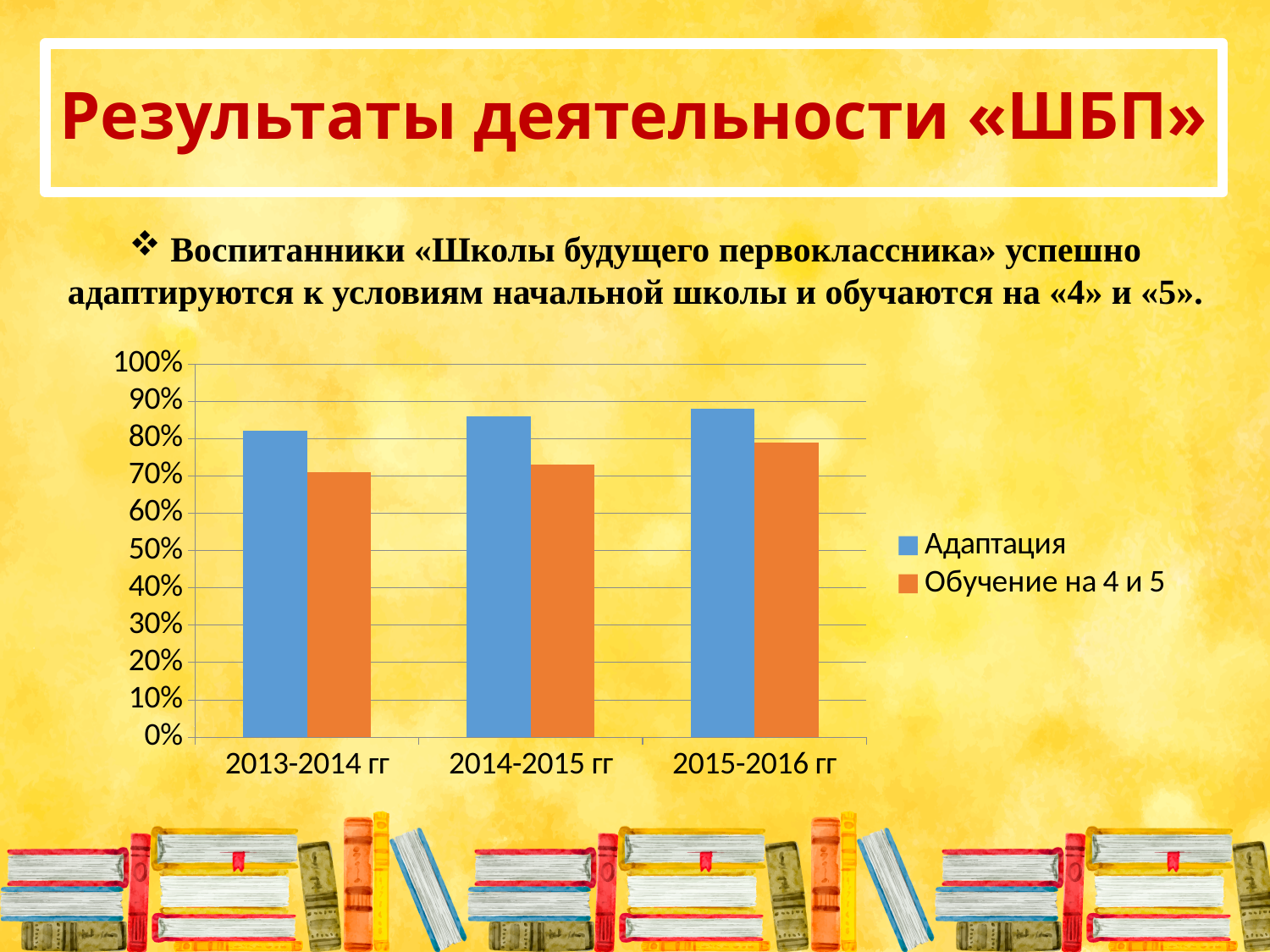
Is the value for Адаптация in 2015-2016 гг greater or less than 90%? less How many year categories are shown on the x axis? 3 Is the value for Обучение на 4 и 5 in 2014-2015 гг greater or less than 80%? less What kind of chart is shown on the slide? bar chart Which series is shown in orange? Обучение на 4 и 5 In which year is the value for Адаптация lowest? 2013-2014 гг Is the value for Обучение на 4 и 5 in 2013-2014 гг greater or less than 60%? greater Do the values for Адаптация rise or fall from 2013-2014 гг to 2015-2016 гг? rise In which year is the value for Адаптация highest? 2015-2016 гг In 2013-2014 гг, which is larger: Адаптация or Обучение на 4 и 5? Адаптация How many series does the legend list? 2 In which year is the value for Обучение на 4 и 5 highest? 2015-2016 гг